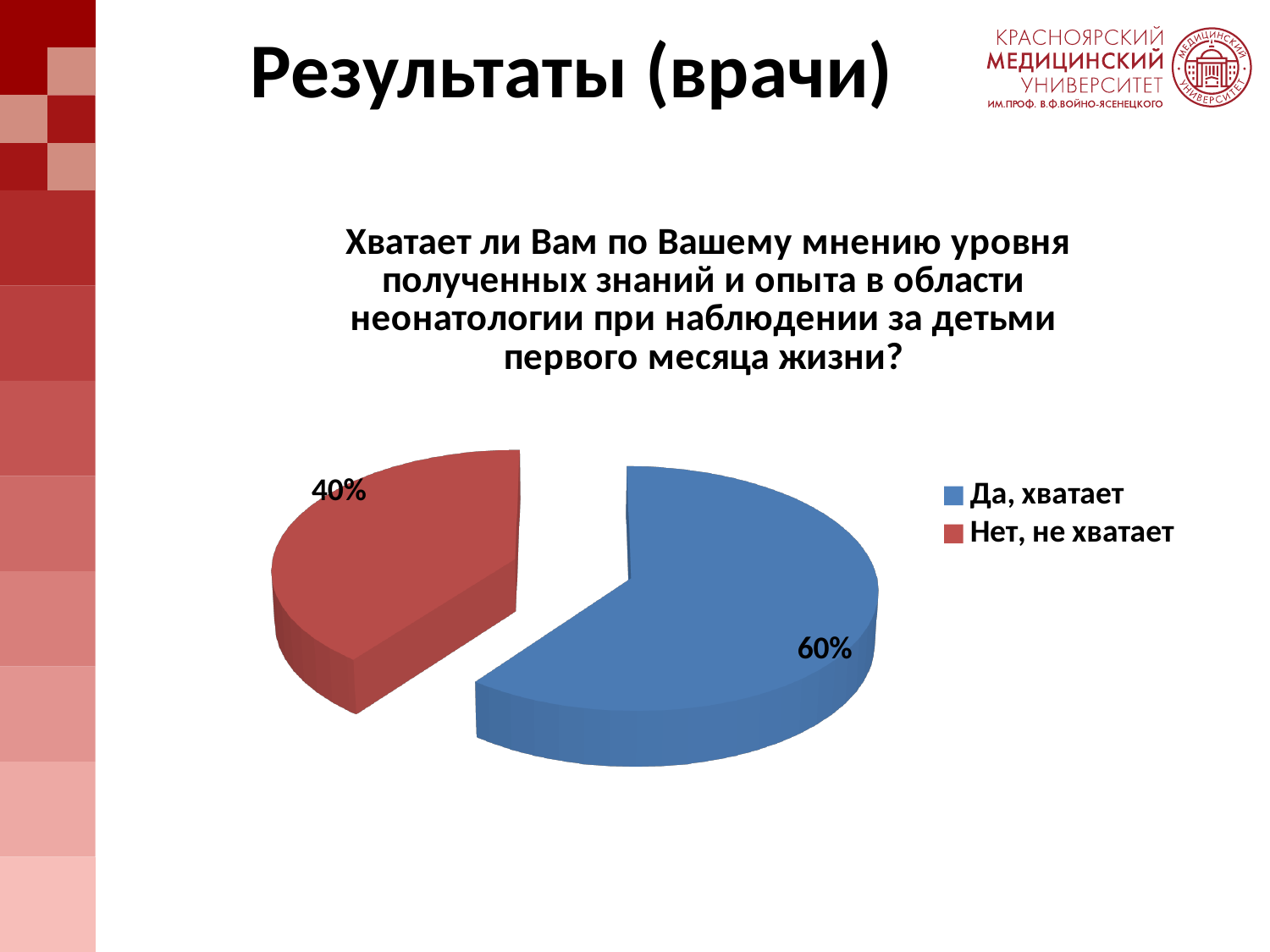
What is the title of the slide? Результаты (врачи) What is the difference in percentage points between "Да, хватает" and "Нет, не хватает"? 20% What share of the pie does the blue slice represent? 60% What percentage of respondents answered "Да, хватает"? 60% What kind of chart is shown on the slide? Pie chart How many slices does the pie chart have? 2 How many entries does the legend list? 2 Which answer has the largest share of the pie? Да, хватает Which colour represents "Нет, не хватает" in the chart? Red What percentage of respondents answered "Нет, не хватает"? 40% Which is larger: the share for "Да, хватает" or for "Нет, не хватает"? Да, хватает Which answer has the smallest share of the pie? Нет, не хватает